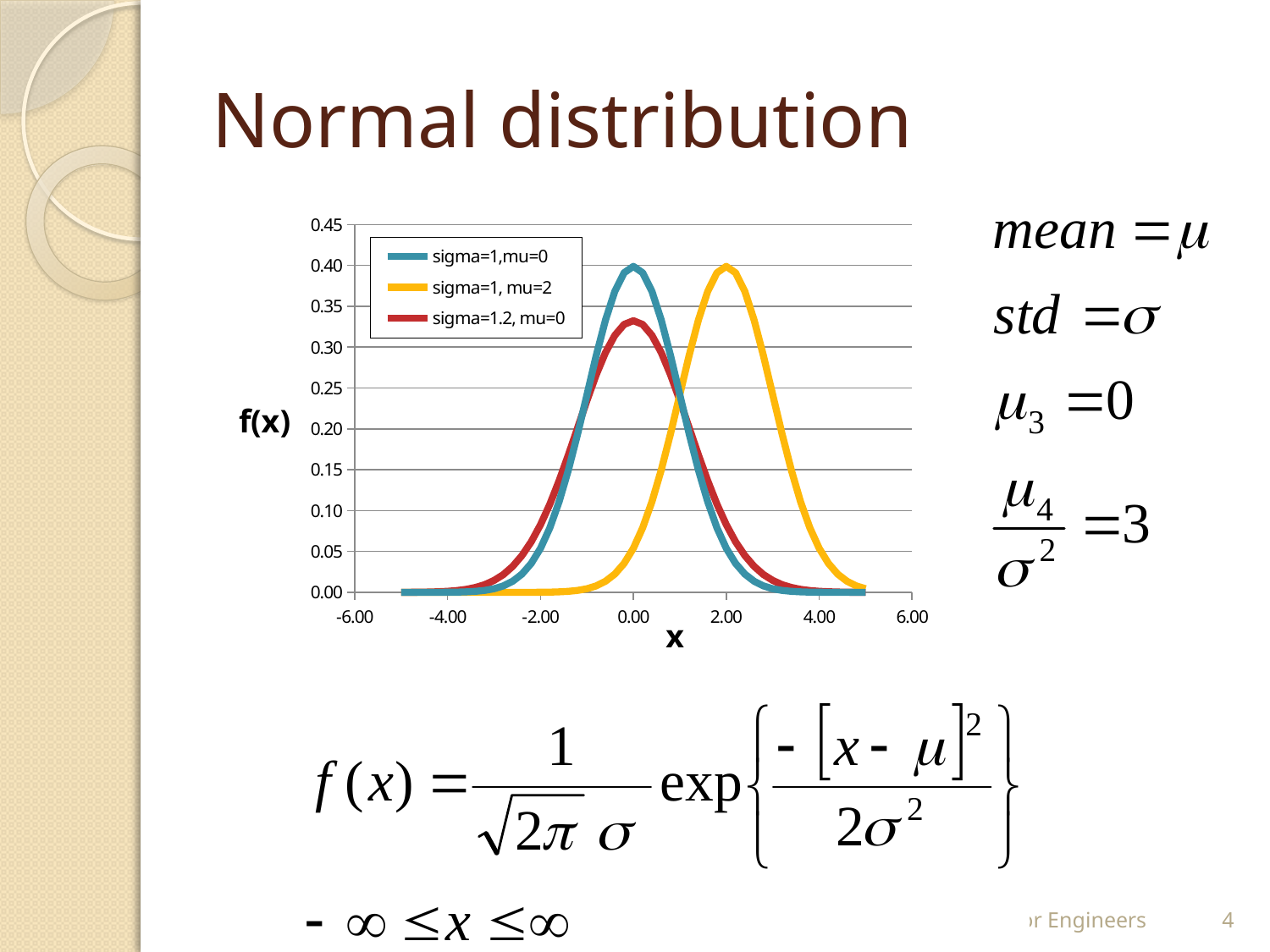
Which curve has the higher peak, sigma=1,mu=0 or sigma=1.2, mu=0? sigma=1,mu=0 At x = -2.00, which curve has the larger value, sigma=1.2, mu=0 or sigma=1, mu=2? sigma=1.2, mu=0 Do the values of the sigma=1,mu=0 curve rise or fall as x goes from 0.00 to 4.00? fall Is the peak value of the sigma=1,mu=0 curve greater or less than 0.35? greater What is the label on the vertical axis of the chart? f(x) What kind of chart is shown on the slide? line chart Is the peak value of the sigma=1, mu=2 curve greater or less than 0.30? greater How many series does the chart legend list? 3 What colour is the line for the series sigma=1, mu=2? yellow At which x value does the sigma=1, mu=2 curve reach its peak? 2.00 Is the peak value of the sigma=1.2, mu=0 curve greater or less than 0.35? less Which series has the lowest peak value? sigma=1.2, mu=0